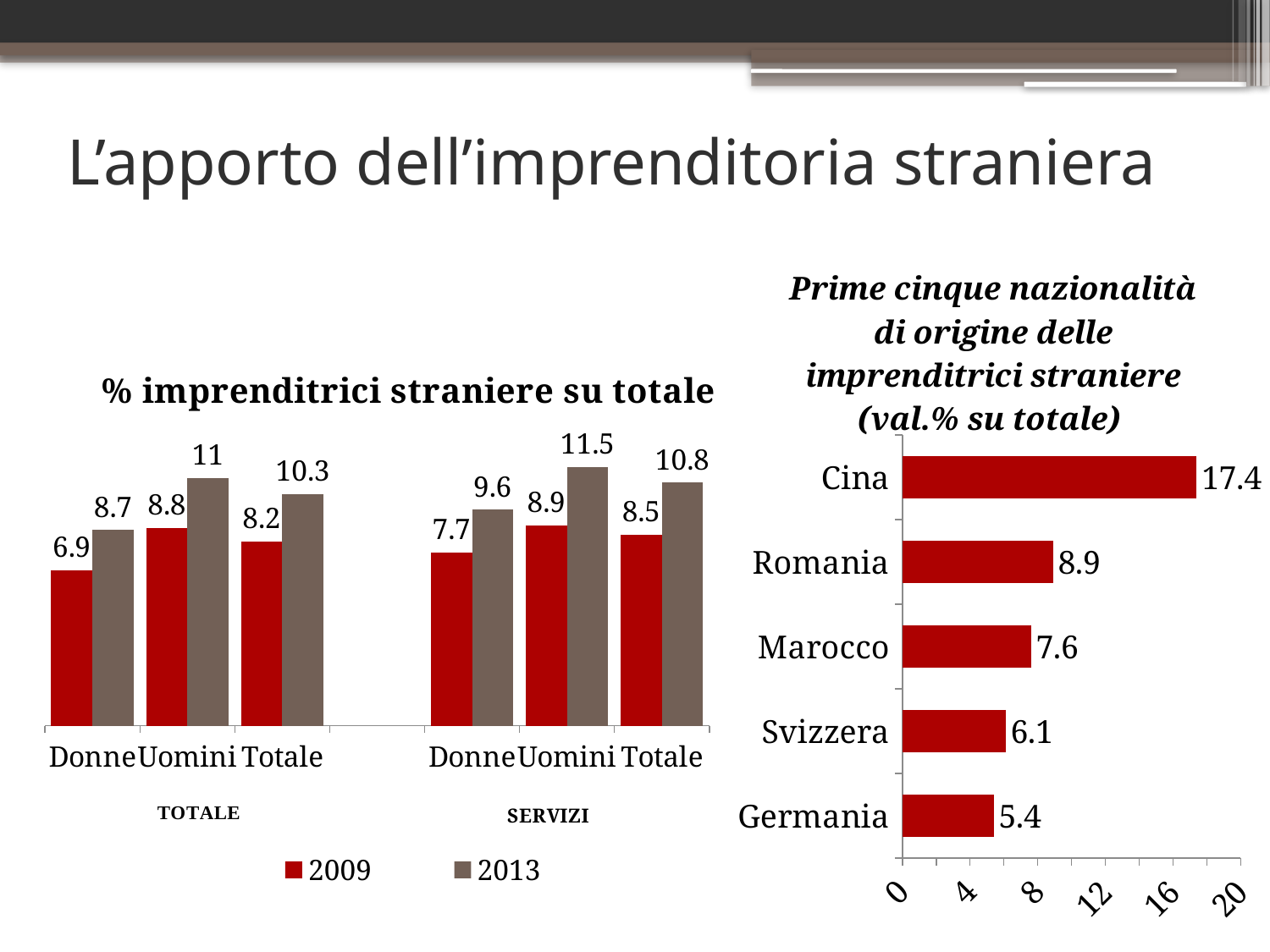
In the chart '% imprenditrici straniere su totale', what is the difference between the 2013 and 2009 values for Totale in the SERVIZI group? 2.3 In the chart 'Prime cinque nazionalità di origine delle imprenditrici straniere', what is the difference between the values for Cina and Romania? 8.5 In the chart '% imprenditrici straniere su totale', what is the 2009 value for Donne in the TOTALE group? 6.9 What kind of chart is 'Prime cinque nazionalità di origine delle imprenditrici straniere'? Bar chart In the chart '% imprenditrici straniere su totale', what is the 2013 value for Uomini in the SERVIZI group? 11.5 In the chart 'Prime cinque nazionalità di origine delle imprenditrici straniere', which nationality has the highest value? Cina In the chart 'Prime cinque nazionalità di origine delle imprenditrici straniere', what is the value for Marocco? 7.6 In the chart '% imprenditrici straniere su totale', which is larger: the 2009 value for Uomini in TOTALE or the 2009 value for Uomini in SERVIZI? Uomini in SERVIZI (8.9) In the chart '% imprenditrici straniere su totale', how many series does the legend list? 2 In the chart '% imprenditrici straniere su totale', which bar has the lowest value? Donne (TOTALE), 2009 In the chart 'Prime cinque nazionalità di origine delle imprenditrici straniere', which nationality has the lowest value? Germania In the chart 'Prime cinque nazionalità di origine delle imprenditrici straniere', how many nationalities are shown? 5